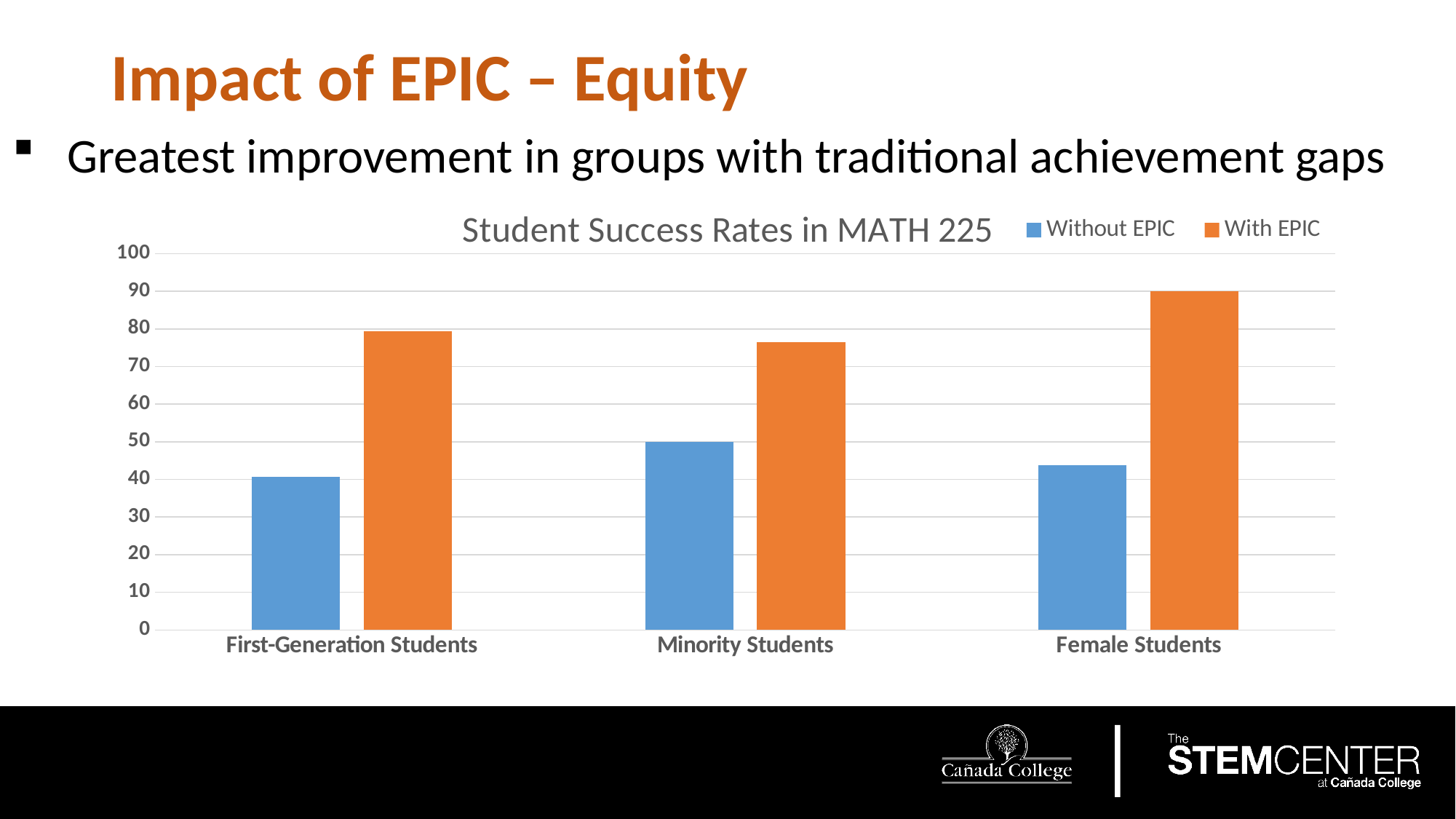
What kind of chart is shown on the slide? bar chart For Minority Students, which is larger: the Without EPIC value or the With EPIC value? With EPIC Is the Without EPIC value for Female Students greater or less than 50? less Which series is shown in orange? With EPIC How many series does the legend list? 2 What is the With EPIC success rate for Female Students? 90 What is the Without EPIC success rate for Minority Students? 50 What is the title of the chart? Student Success Rates in MATH 225 Which student group has the lowest Without EPIC success rate? First-Generation Students Is the With EPIC value for First-Generation Students greater or less than 70? greater How many student groups are shown on the x axis? 3 Which student group has the highest With EPIC success rate? Female Students